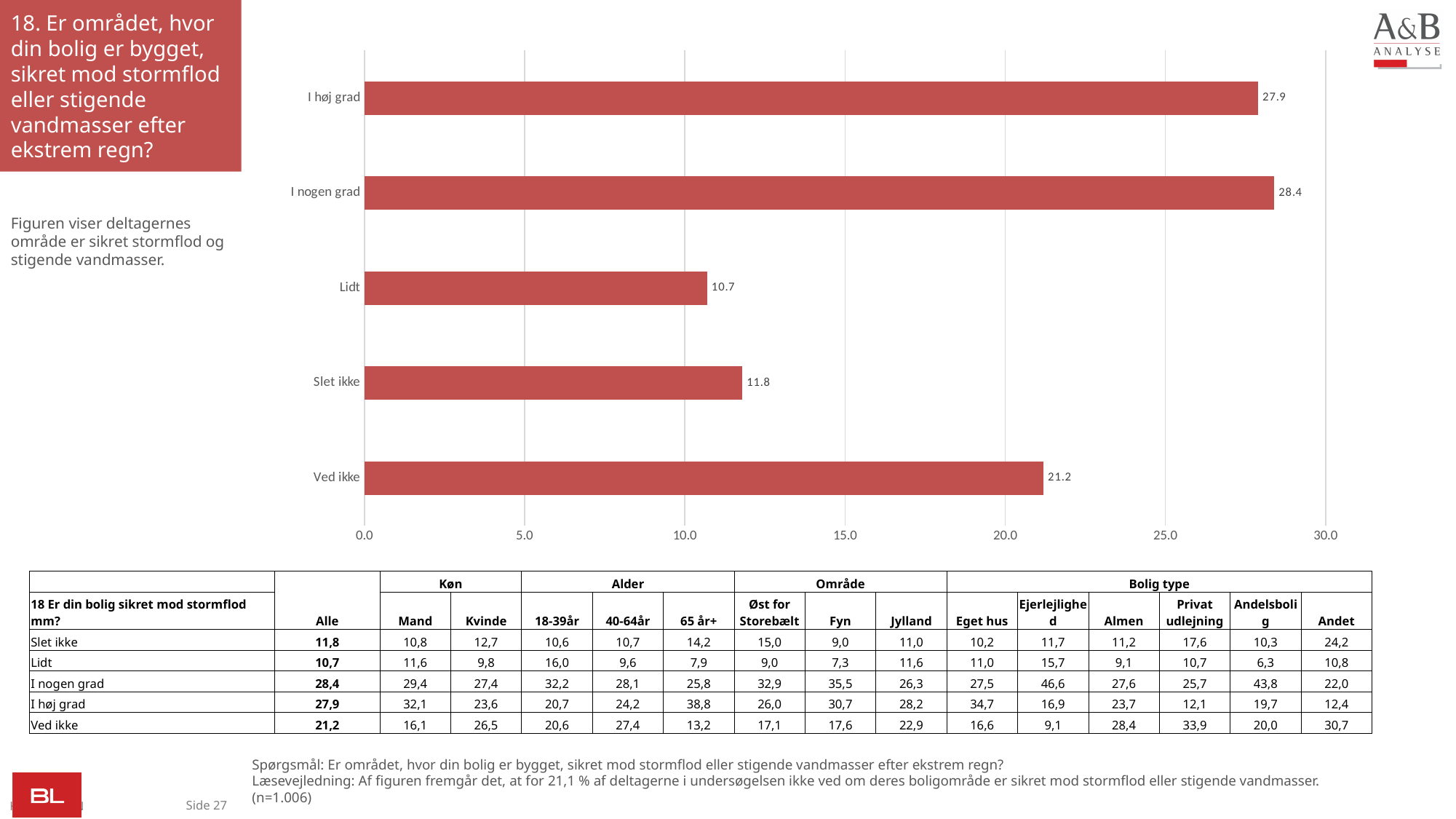
What is the difference between the values for "Ved ikke" and "Slet ikke"? 9.4 What is the value for "Ved ikke"? 21.2 Which is larger, the value for "Slet ikke" or the value for "Lidt"? Slet ikke What is the difference between the values for "I nogen grad" and "I høj grad"? 0.5 What is the value for "Lidt"? 10.7 What kind of chart is shown on the slide? bar chart What is the maximum value shown on the x axis? 30.0 Which category has the highest value? I nogen grad Is the value for "Ved ikke" greater or less than 20.0? greater What is the value for "I høj grad"? 27.9 How many categories are shown in the chart? 5 Which category has the lowest value? Lidt